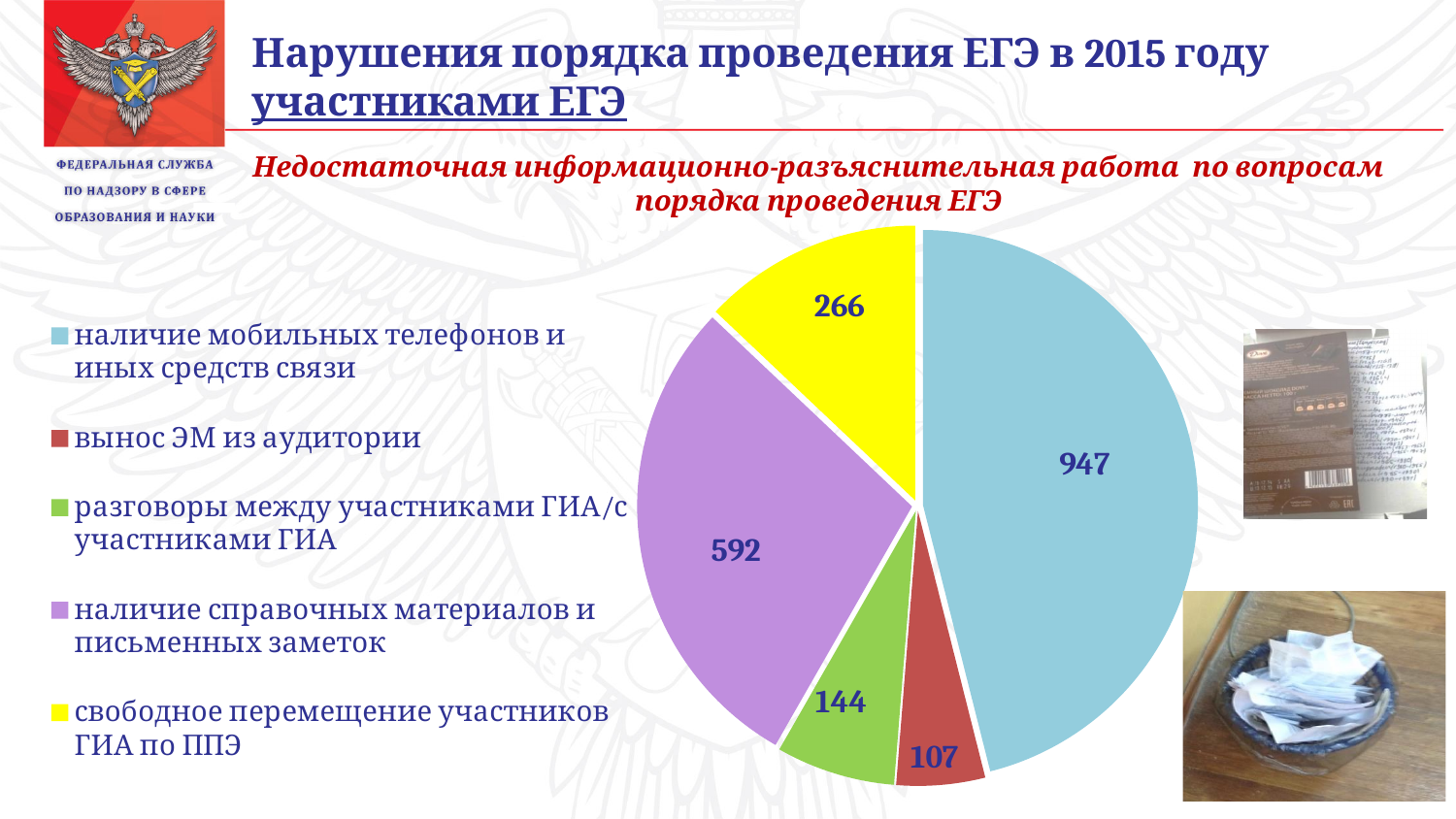
What is the value for "свободное перемещение участников ГИА по ППЭ"? 266 What is the difference between the values for "наличие мобильных телефонов и иных средств связи" and "наличие справочных материалов и письменных заметок"? 355 What is the value for "вынос ЭМ из аудитории"? 107 How many slices does the pie chart have? 5 What colour is the slice for "свободное перемещение участников ГИА по ППЭ"? yellow What type of chart is shown on the slide? pie chart Which category has the smallest value? вынос ЭМ из аудитории What is the value for "наличие мобильных телефонов и иных средств связи"? 947 Which is larger: the value for "свободное перемещение участников ГИА по ППЭ" or for "разговоры между участниками ГИА/с участниками ГИА"? свободное перемещение участников ГИА по ППЭ What is the value for "разговоры между участниками ГИА/с участниками ГИА"? 144 What is the value for "наличие справочных материалов и письменных заметок"? 592 Which category has the largest value? наличие мобильных телефонов и иных средств связи